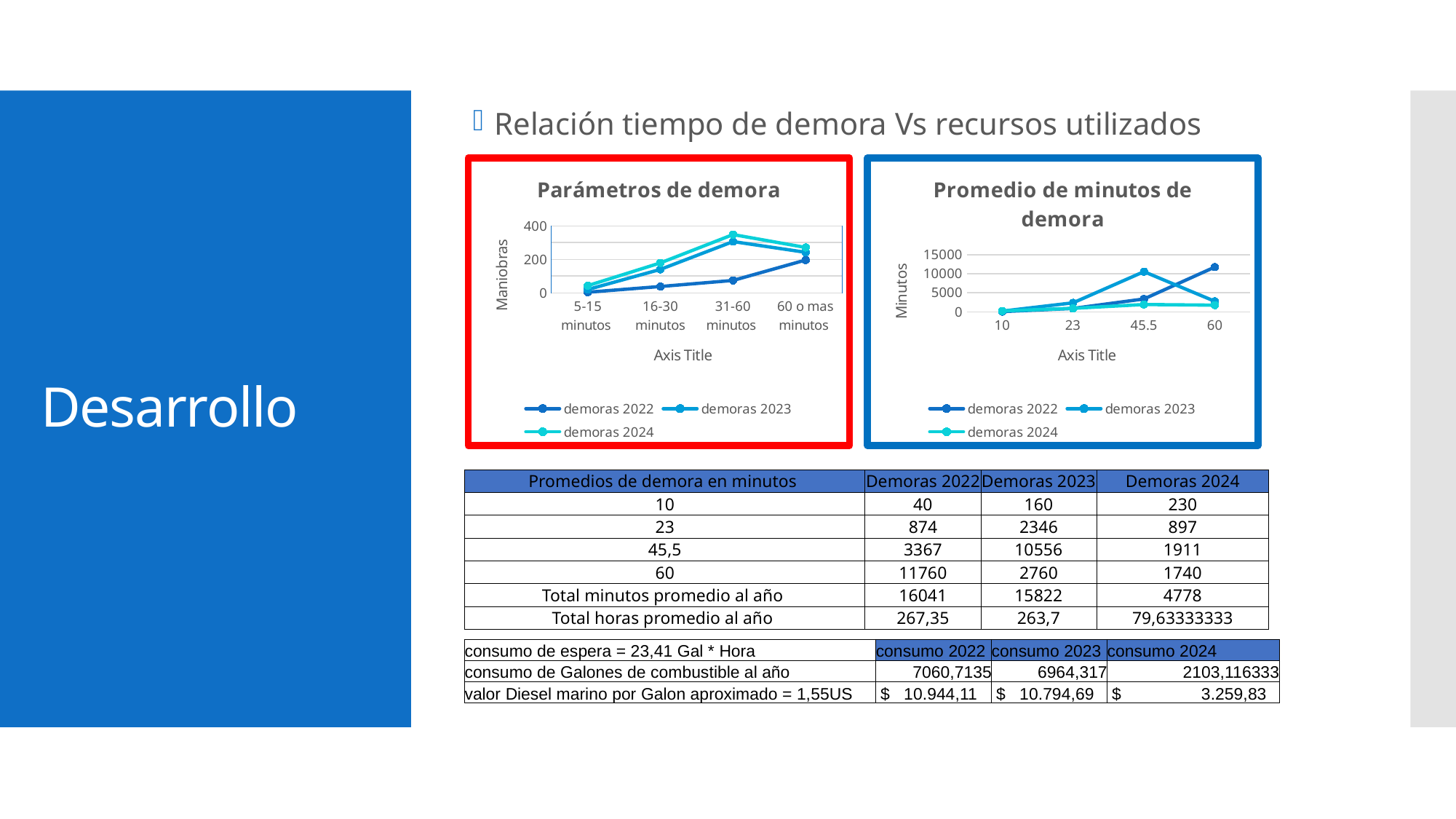
How many categories are shown on the x axis of the 'Parámetros de demora' chart? 4 In the 'Parámetros de demora' chart, does the demoras 2022 series rise or fall from '5-15 minutos' to '60 o mas minutos'? rises In the 'Promedio de minutos de demora' chart, is the value for demoras 2022 at 60 greater or less than 10000? greater What kind of chart is the 'Promedio de minutos de demora' chart? line chart What is the y-axis title of the 'Parámetros de demora' chart? Maniobras In the 'Promedio de minutos de demora' chart, at which x value does the demoras 2023 series reach its highest point? 45.5 In the 'Parámetros de demora' chart, is the value for demoras 2022 at '60 o mas minutos' greater or less than 100? greater What is the y-axis title of the 'Promedio de minutos de demora' chart? Minutos In the 'Promedio de minutos de demora' chart, at x value 60, which series is higher: demoras 2022 or demoras 2023? demoras 2022 How many series does the legend of the 'Parámetros de demora' chart list? 3 What kind of chart is the 'Parámetros de demora' chart? line chart